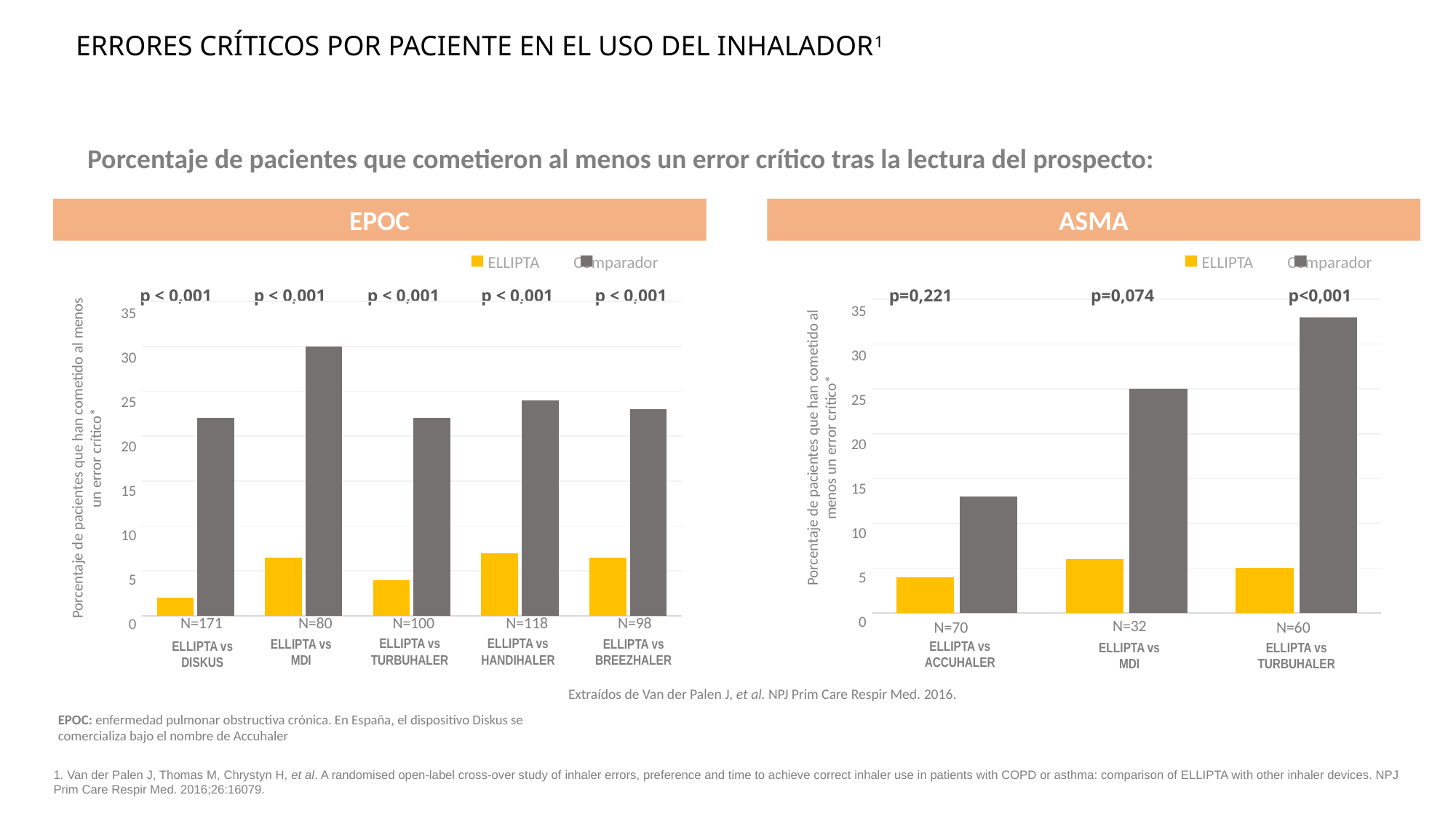
On the EPOC chart, how many series does the legend list? 2 On the ASMA chart, which comparison has the lowest Comparador value? ELLIPTA vs ACCUHALER On the ASMA chart, which comparison has the highest Comparador value? ELLIPTA vs TURBUHALER On the ASMA chart, what p-value is shown above the ELLIPTA vs MDI comparison? p=0,074 On the ASMA chart, is the Comparador value for ELLIPTA vs ACCUHALER greater or less than 15? less On the EPOC chart, which comparison has the lowest ELLIPTA value? ELLIPTA vs DISKUS On the EPOC chart, which comparison has the highest Comparador value? ELLIPTA vs MDI On the EPOC chart, how many comparison categories are shown on the x axis? 5 On the EPOC chart, for ELLIPTA vs DISKUS, which series has the larger value, ELLIPTA or Comparador? Comparador On the ASMA chart, how many comparison categories are shown on the x axis? 3 On the EPOC chart, what kind of chart is used? Bar chart